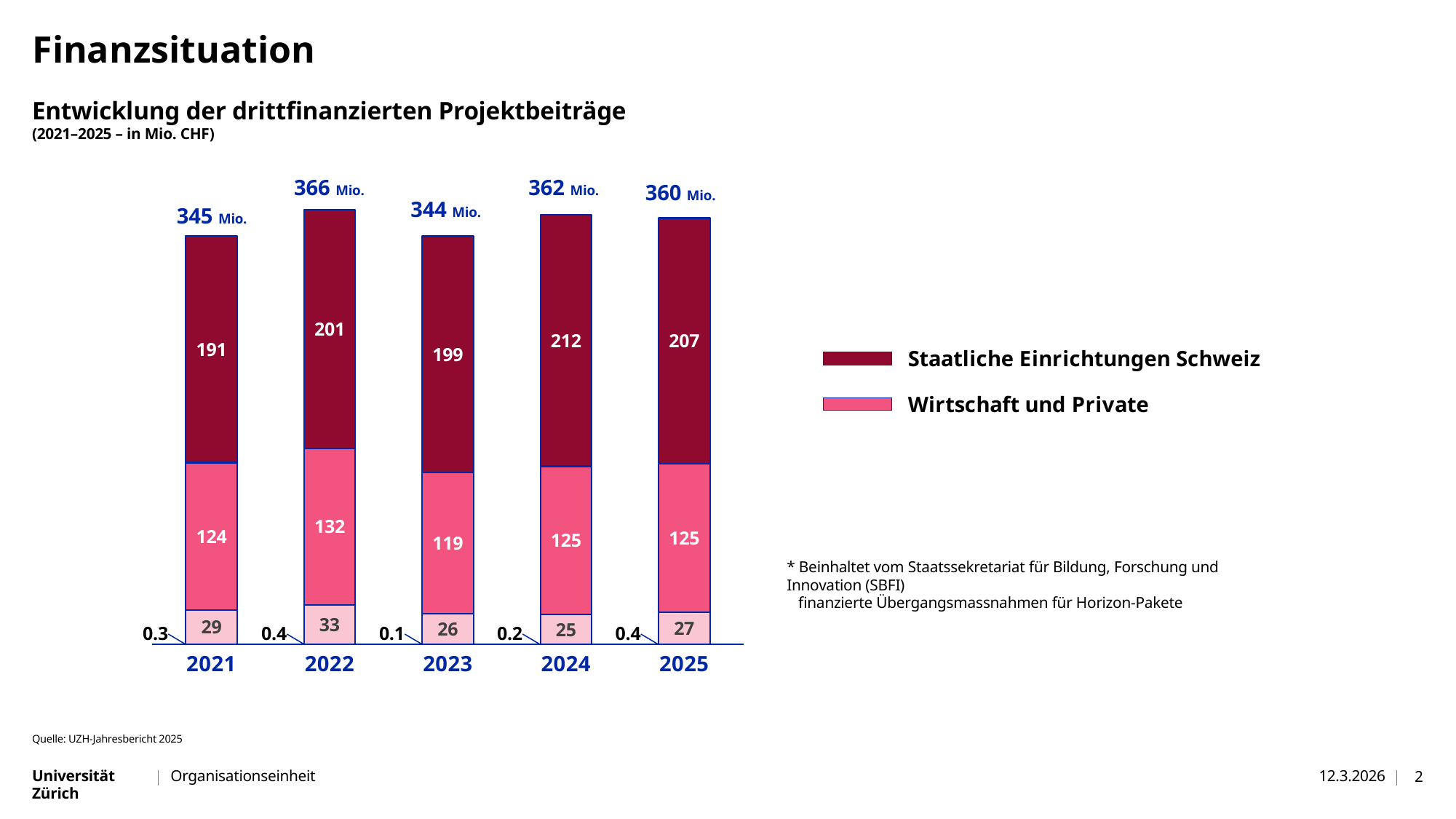
Which year has the highest total? 2022 Does the total rise or fall from 2021 to 2022? Rise How many series does the legend list? 2 What is the total shown above the 2025 bar? 360 Mio. What kind of chart is shown? Stacked bar chart How many years are shown on the x axis? 5 Which year has the larger Wirtschaft und Private value, 2022 or 2023? 2022 What is the value for Staatliche Einrichtungen Schweiz in 2024? 212 What is the difference between the Staatliche Einrichtungen Schweiz values for 2024 and 2021? 21 What is the value for Wirtschaft und Private in 2022? 132 What is the total shown above the 2022 bar? 366 Mio. Which year has the lowest total? 2023